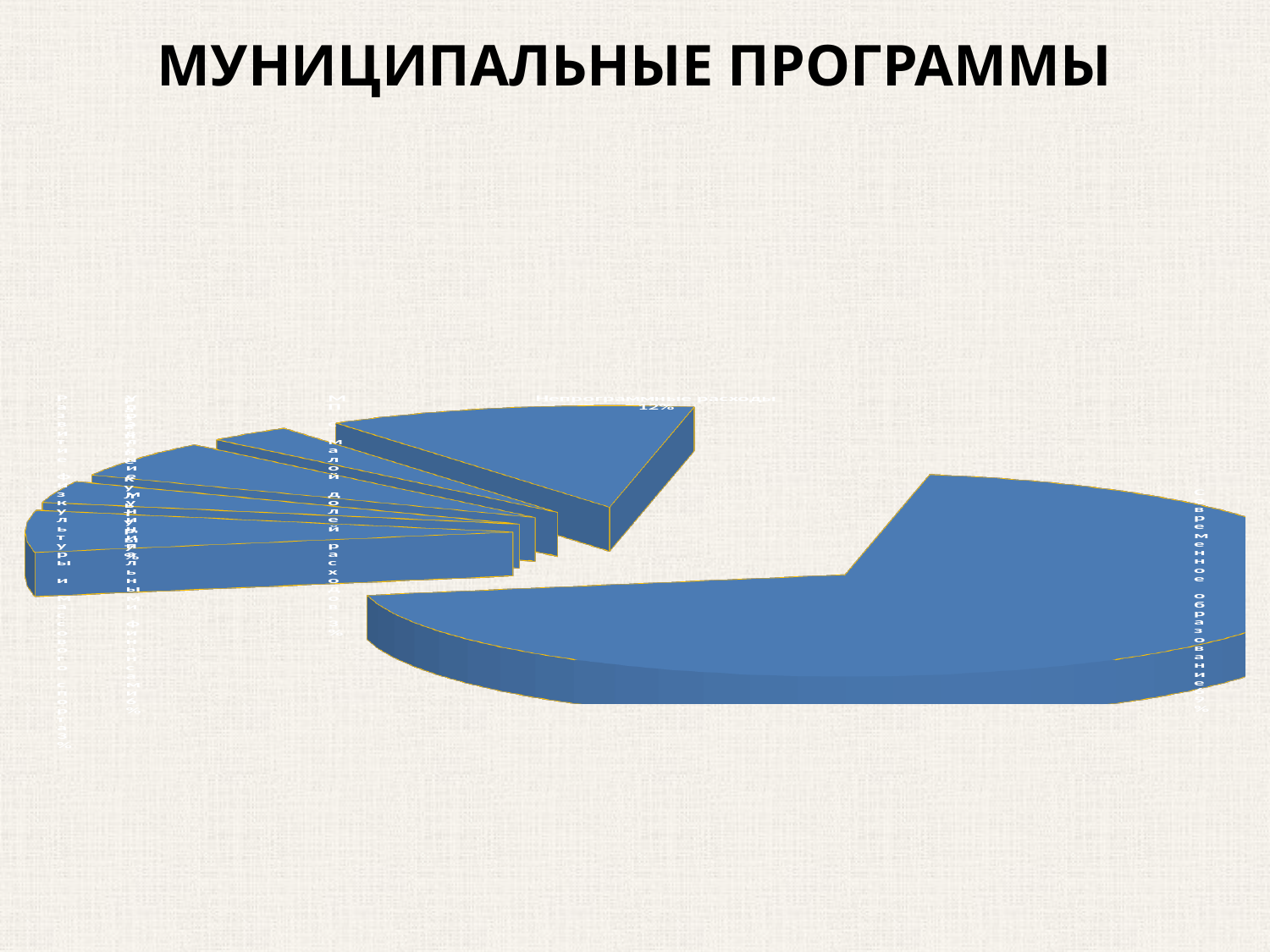
What colour are the slices of the pie chart? blue What kind of chart is shown on the slide? pie chart What is the title of the slide? МУНИЦИПАЛЬНЫЕ ПРОГРАММЫ Which slice of the pie is the largest? Современное образование What share of the pie is labelled for Непрограммные расходы? 12% Which slice is larger: Современное образование or Непрограммные расходы? Современное образование